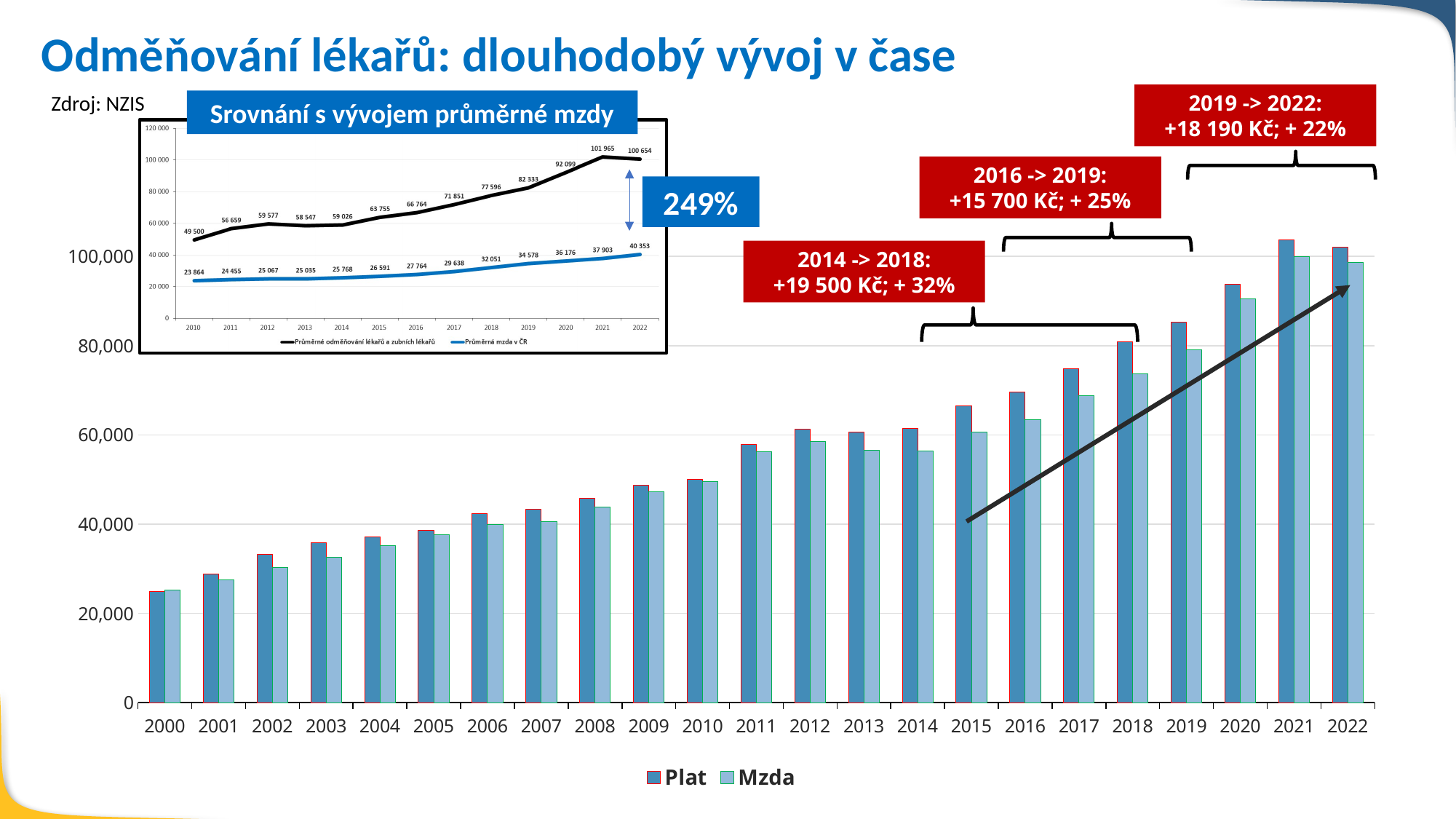
In the large bar chart, how many years are shown on the x axis? 23 In the large bar chart, is the Mzda value for 2000 greater or less than 40,000? less In the large bar chart, is the Plat value for 2021 greater or less than 100,000? greater What kind of chart is the large chart at the bottom of the slide? bar chart In the inset chart 'Srovnání s vývojem průměrné mzdy', what is the value of Průměrné odměňování lékařů a zubních lékařů in 2021? 101 965 In the inset chart 'Srovnání s vývojem průměrné mzdy', in which year is Průměrná mzda v ČR lowest? 2010 In the large bar chart, which year has the highest Plat value? 2021 In the large bar chart, do the Plat values generally rise or fall from 2000 to 2022? rise In the inset chart 'Srovnání s vývojem průměrné mzdy', what is the value of Průměrná mzda v ČR in 2022? 40 353 In the inset chart 'Srovnání s vývojem průměrné mzdy', what is the difference between Průměrné odměňování lékařů a zubních lékařů and Průměrná mzda v ČR in 2022? 60 301 In the large bar chart, how many series does the legend list? 2 In the inset chart 'Srovnání s vývojem průměrné mzdy', how many years are plotted? 13